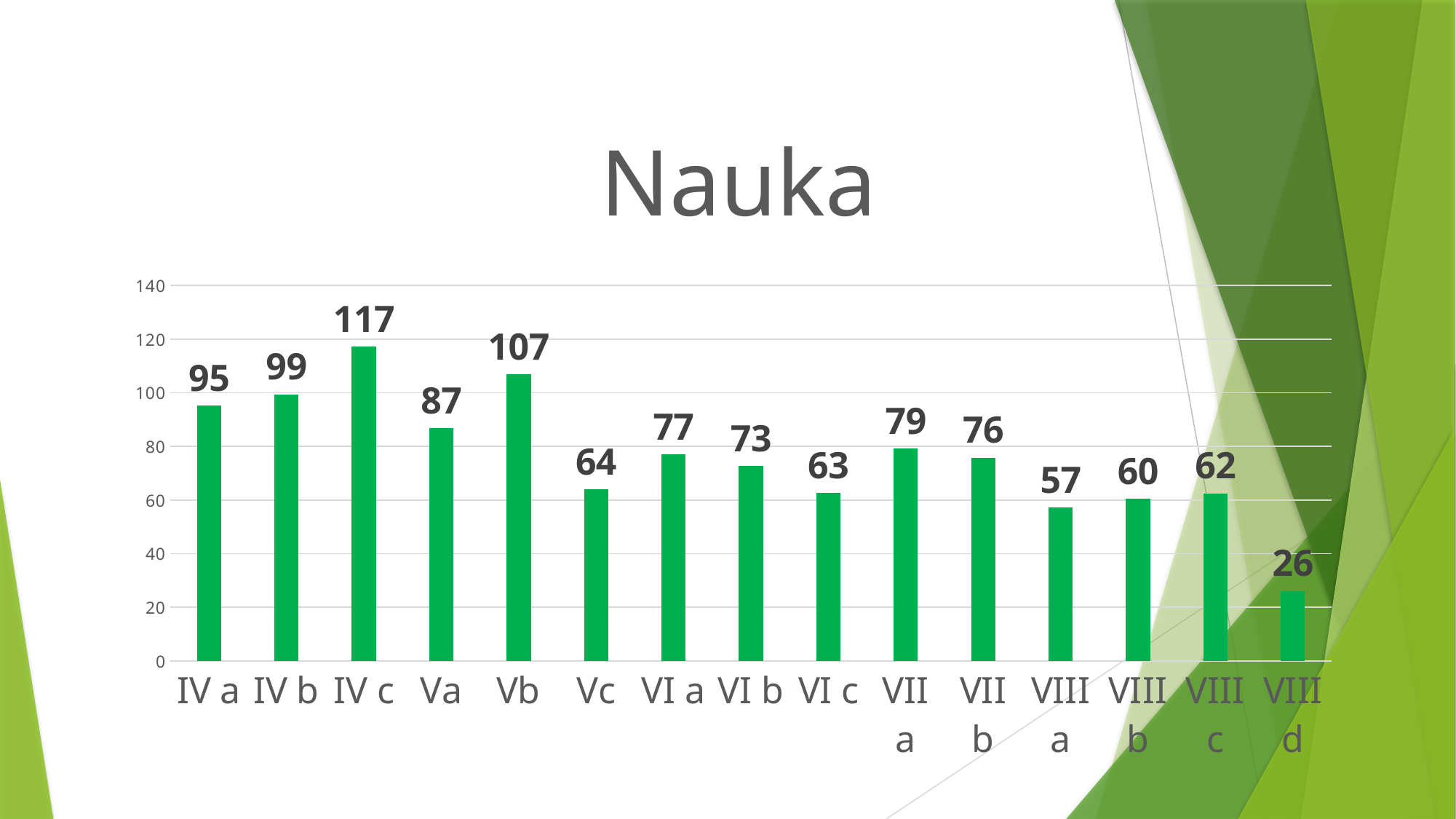
How many categories are shown on the x axis? 15 What kind of chart is shown on the slide? bar chart Which category has the highest value? IV c Which category has the lowest value? VIII d What is the value for Vb? 107 What is the value for VIII d? 26 Which is larger, the value for VII a or the value for VIII a? VII a What is the difference between the values for IV c and Vb? 10 What is the title of the slide? Nauka What is the value for IV c? 117 Is the value for Va greater or less than 80? greater What is the difference between the values for VI a and VI c? 14